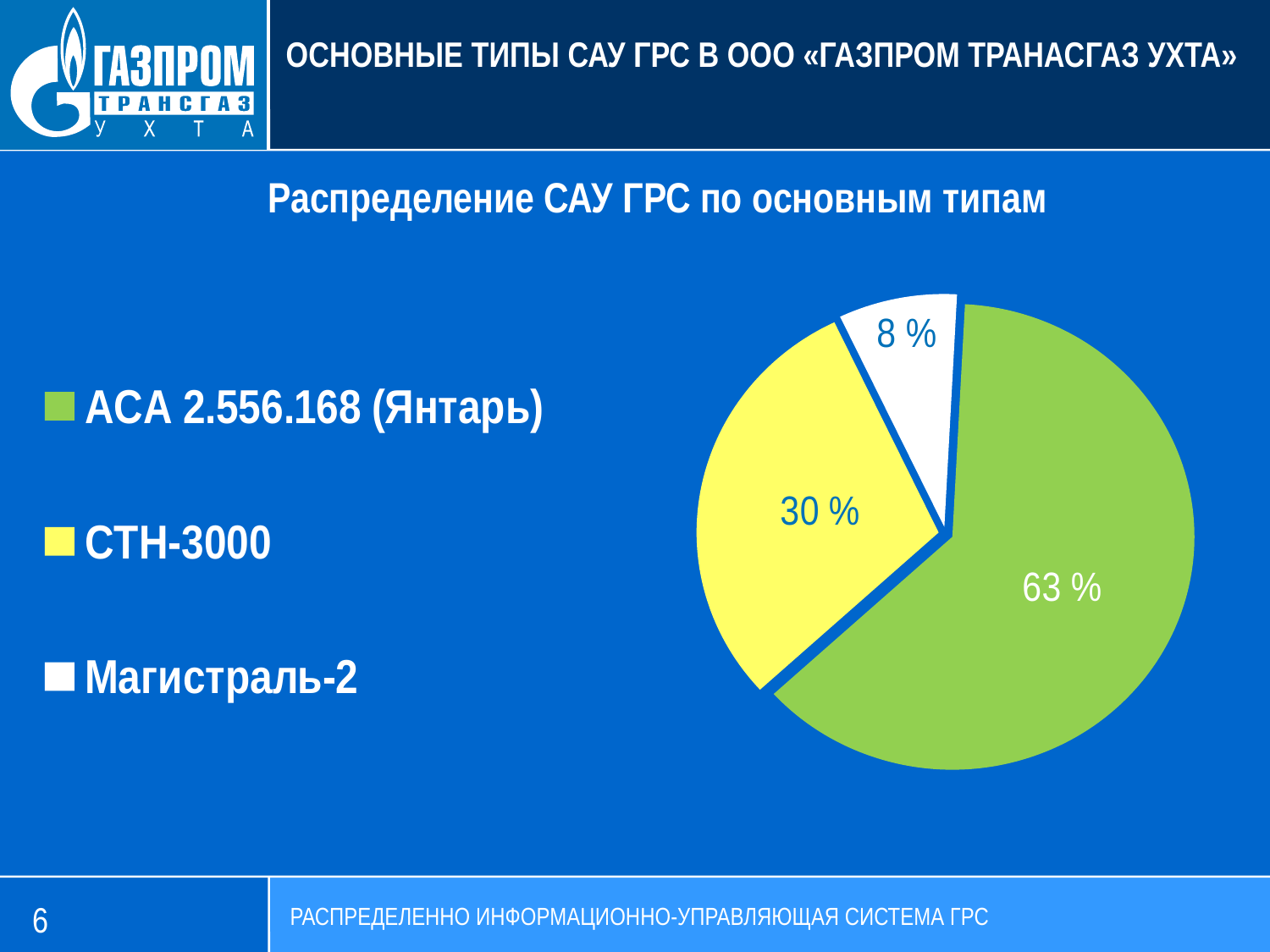
What share of the pie does СТН-3000 have? 30 % Which is larger, the share for СТН-3000 or the share for Магистраль-2? СТН-3000 What is the title of the chart? Распределение САУ ГРС по основным типам Which category has the largest slice of the pie? АСА 2.556.168 (Янтарь) What is the difference in percentage points between the АСА 2.556.168 (Янтарь) slice and the СТН-3000 slice? 33 What share of the pie does Магистраль-2 have? 8 % How many categories does the pie chart show? 3 What colour is the slice for СТН-3000? yellow What kind of chart is shown on the slide? pie chart Which category has the smallest slice of the pie? Магистраль-2 What share of the pie does АСА 2.556.168 (Янтарь) have? 63 % What is the difference in percentage points between the СТН-3000 slice and the Магистраль-2 slice? 22